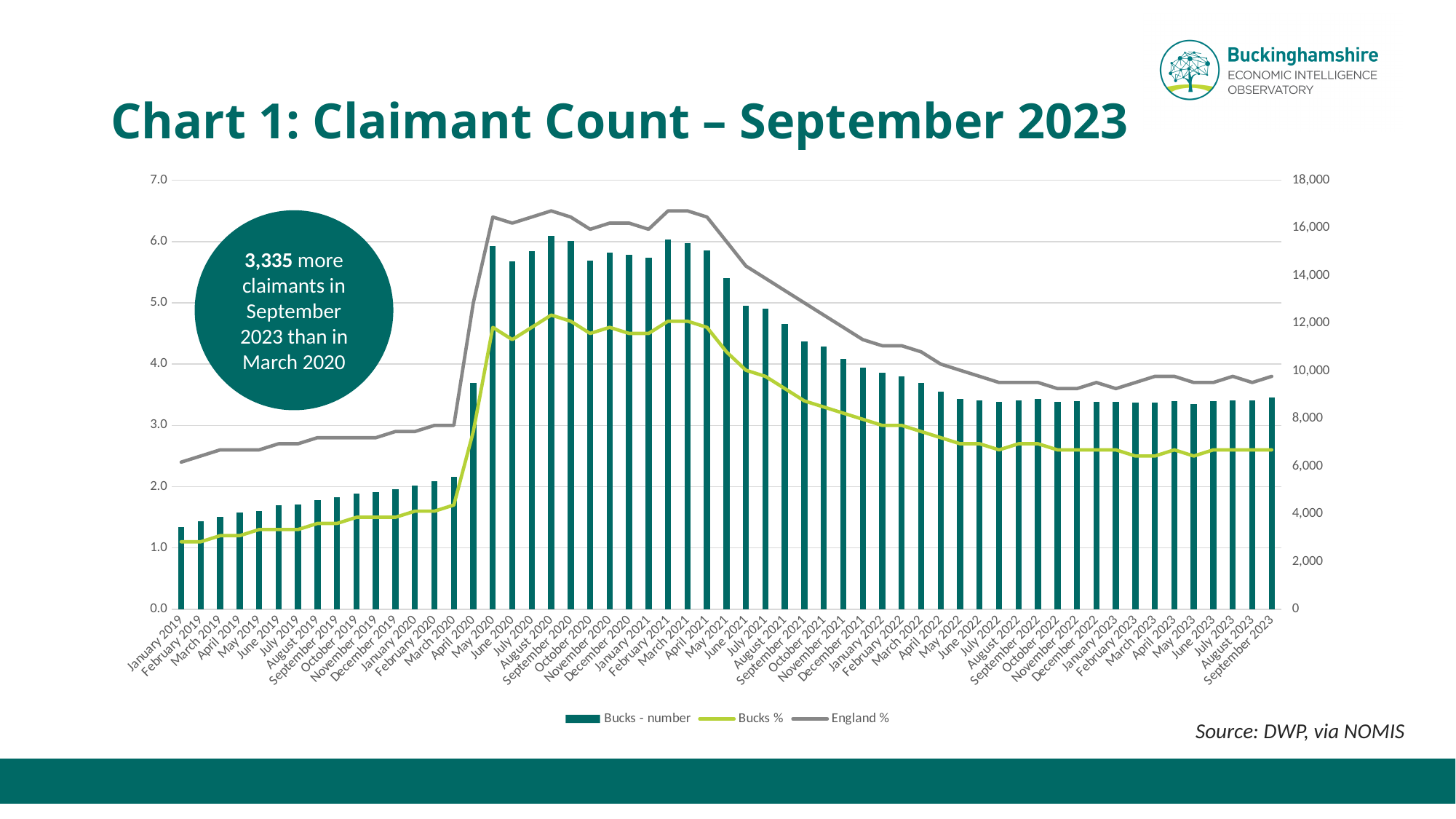
What is the title of the chart? Chart 1: Claimant Count – September 2023 Which month has the lowest Bucks - number bar? January 2019 How many series does the legend list? 3 Is the Bucks - number value for September 2023 greater or less than 10,000? less In September 2023, which is higher: Bucks % or England %? England % What kind of chart is this? Combined bar and line chart According to the callout, how many more claimants were there in September 2023 than in March 2020? 3,335 Is the England % value for September 2020 greater or less than 6.0? greater Do the Bucks - number bars rise or fall from January 2019 to March 2020? rise What are the three series named in the legend? Bucks - number, Bucks %, England % Is the Bucks - number value for August 2020 greater or less than 14,000? greater